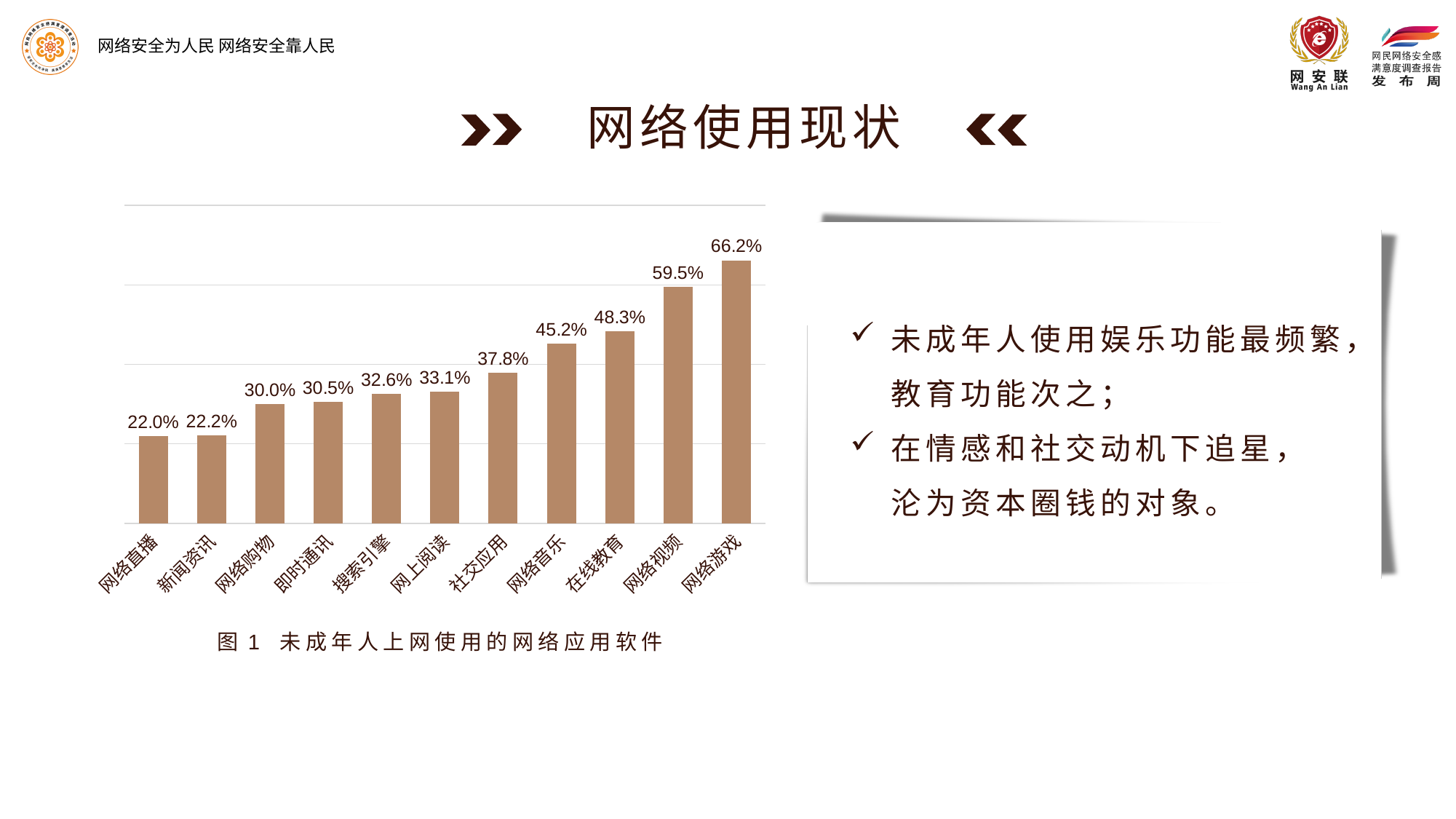
What is the caption of the chart? 图 1 未成年人上网使用的网络应用软件 What kind of chart is shown on the slide? Bar chart Do the values rise or fall from left to right along the x axis? Rise Which category has the lowest value? 网络直播 What is the difference between the values for 网络游戏 and 网络视频? 6.7% Which is larger, the value for 网络购物 or the value for 搜索引擎? 搜索引擎 Which category has the highest value? 网络游戏 What is the difference between the values for 在线教育 and 网络音乐? 3.1% What is the value for 社交应用? 37.8% What is the value for 网络游戏? 66.2% What is the value for 网络直播? 22.0% How many categories are shown in the chart? 11